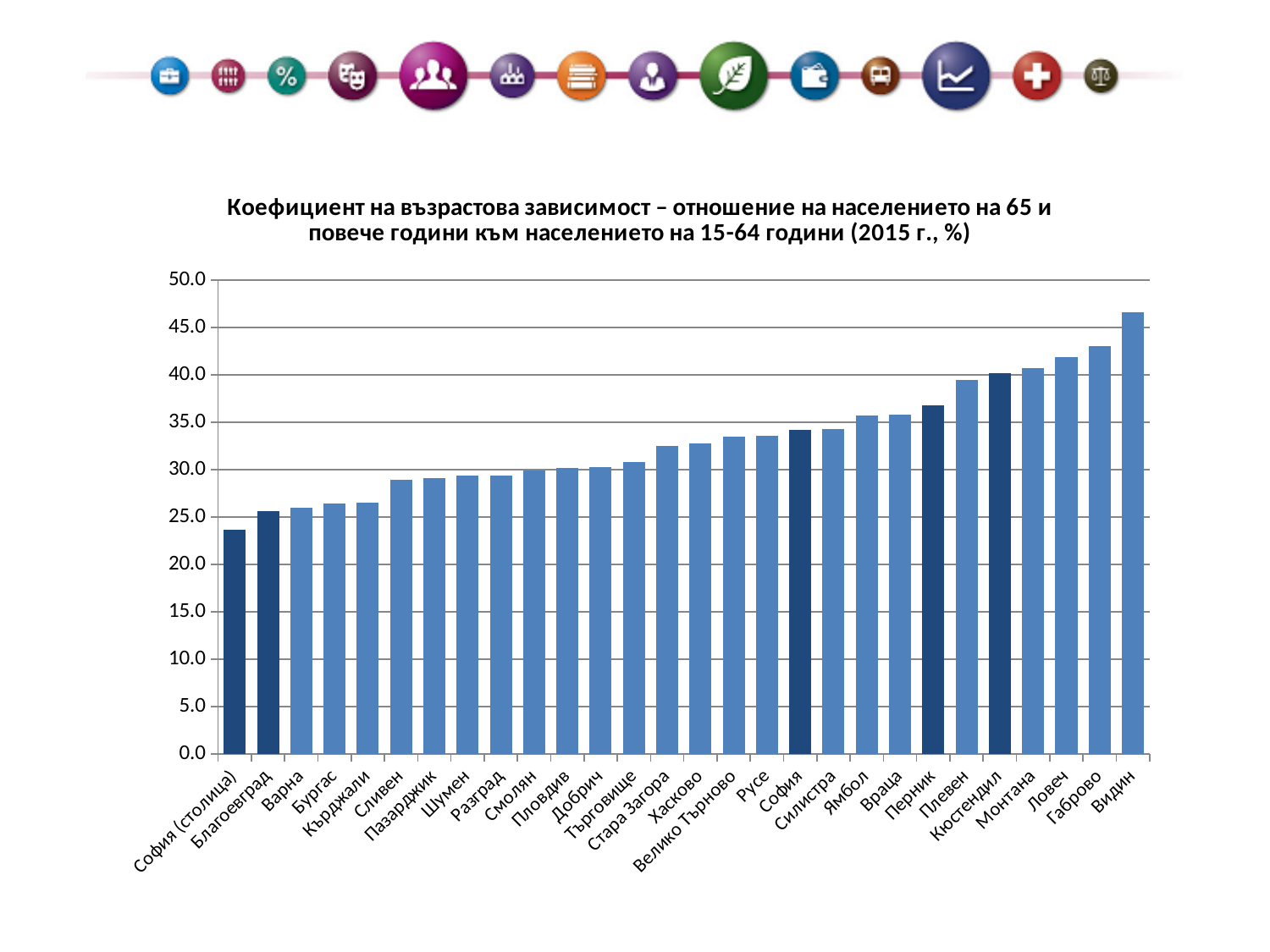
Which region has the highest value on the chart? Видин Is the value for Перник greater or less than 35.0? greater Which has the larger value, Варна or Ловеч? Ловеч Is the value for София (столица) greater or less than 25.0? less What kind of chart is shown on the slide? bar chart Which year does the chart title say the data refers to? 2015 г. Do the values rise or fall moving from left to right along the x axis? rise Is the value for Сливен greater or less than 30.0? less Which region has the lowest value on the chart? София (столица) How many regions (categories) are plotted on the chart? 28